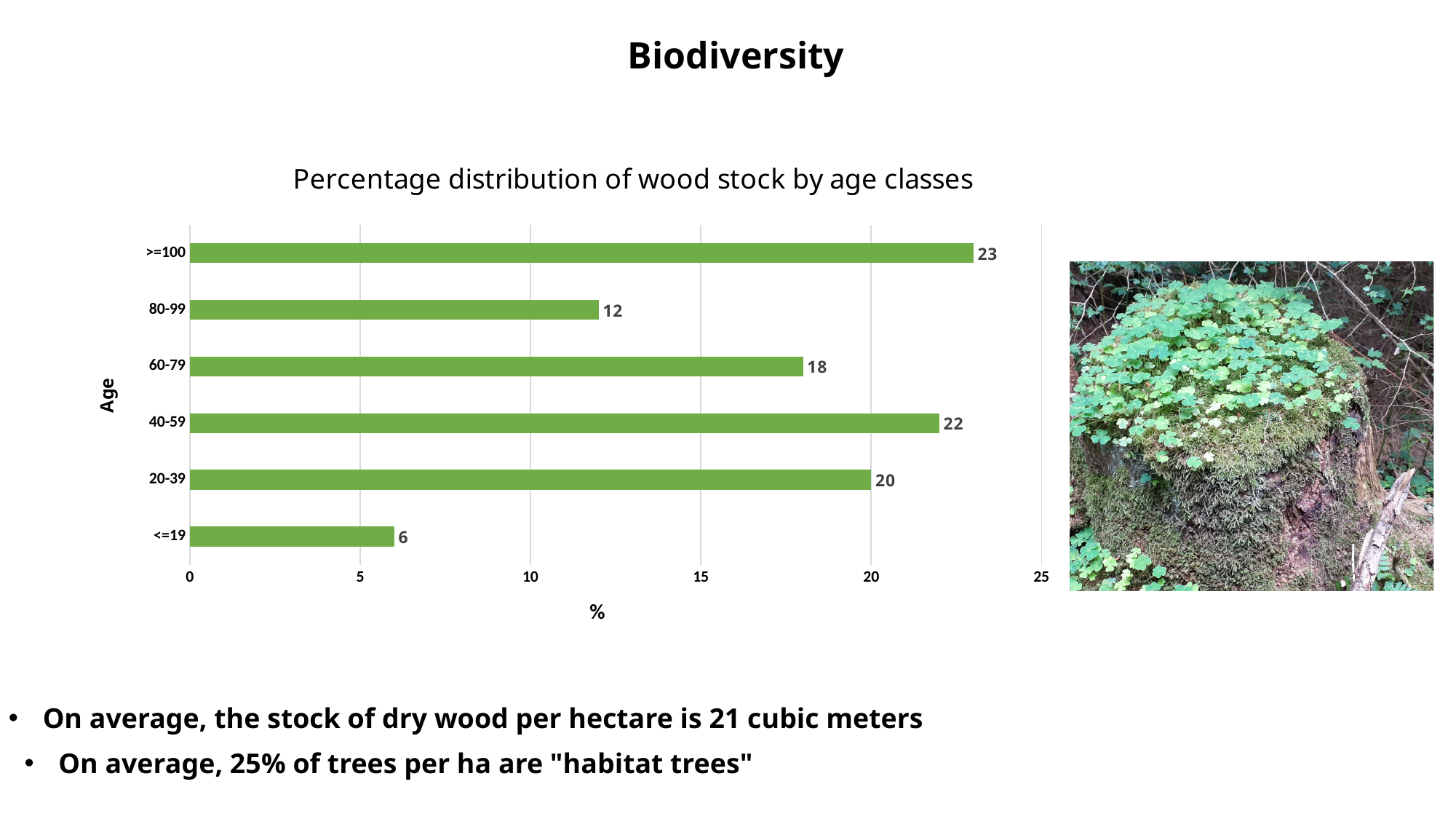
What is the difference between the values for the 40-59 and 60-79 age classes? 4 What is the label of the horizontal axis of the chart? % What is the value for the >=100 age class? 23 What kind of chart is shown on the slide? bar chart What is the value for the <=19 age class? 6 Is the value for the 60-79 age class greater or less than 15? greater How many age classes are shown in the chart? 6 Which age class has the lowest percentage of wood stock? <=19 Which age class has the highest percentage of wood stock? >=100 What is the value for the 80-99 age class? 12 Which is larger, the value for 20-39 or the value for 80-99? 20-39 What is the title of the chart? Percentage distribution of wood stock by age classes